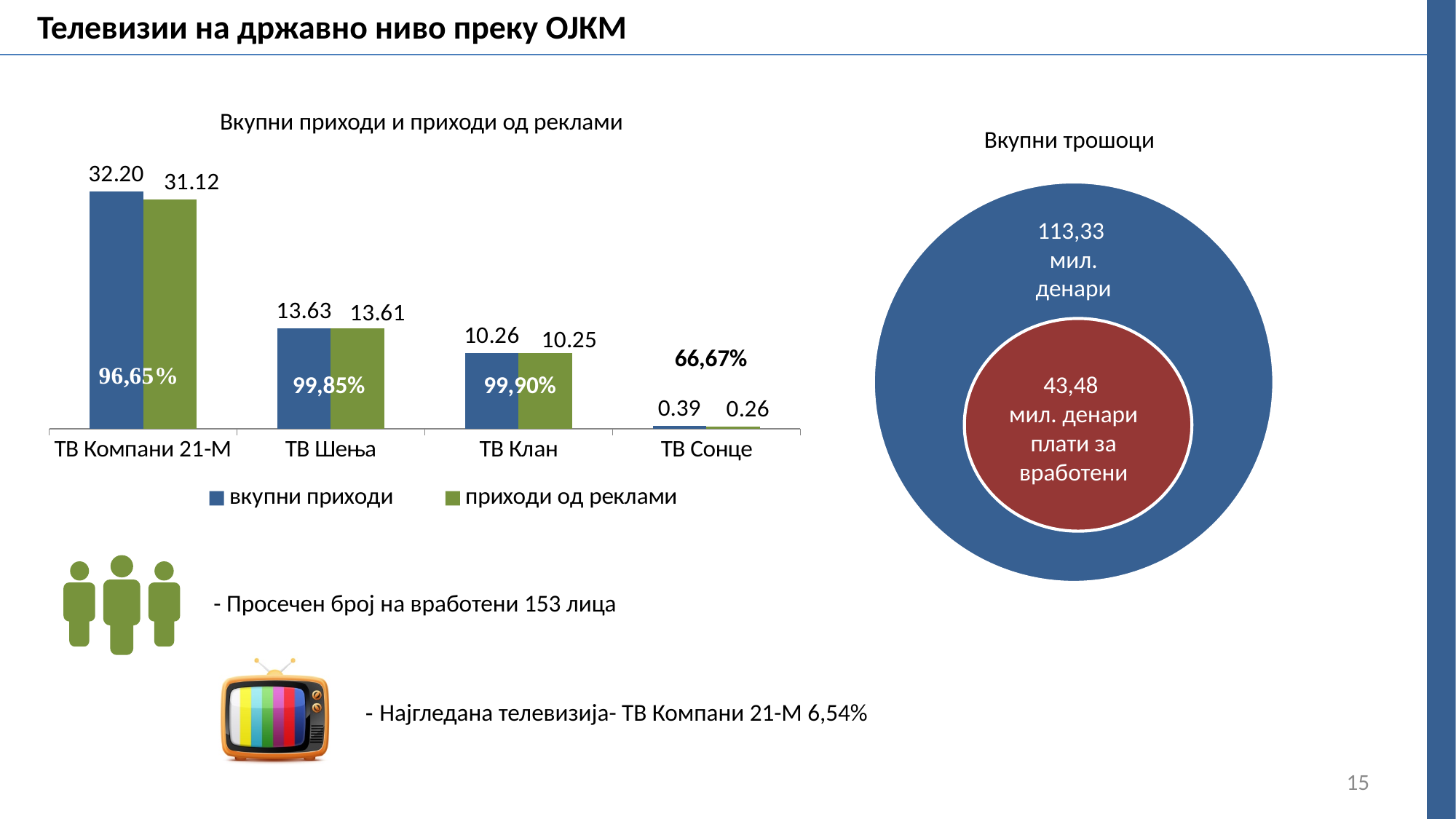
In the chart 'Вкупни приходи и приходи од реклами', which category has the lowest 'приходи од реклами'? ТВ Сонце In the chart 'Вкупни приходи и приходи од реклами', which is larger: 'вкупни приходи' for ТВ Шења or 'вкупни приходи' for ТВ Клан? ТВ Шења In the chart 'Вкупни приходи и приходи од реклами', what is the difference between 'вкупни приходи' and 'приходи од реклами' for ТВ Компани 21-М? 1.08 In the chart 'Вкупни приходи и приходи од реклами', what is the value of 'приходи од реклами' for ТВ Шења? 13.61 In the chart 'Вкупни приходи и приходи од реклами', what is the value of 'вкупни приходи' for ТВ Компани 21-М? 32.20 In the chart 'Вкупни приходи и приходи од реклами', what is the value of 'вкупни приходи' for ТВ Клан? 10.26 In the chart 'Вкупни приходи и приходи од реклами', which category has the highest 'вкупни приходи'? ТВ Компани 21-М How many categories are shown in the chart 'Вкупни приходи и приходи од реклами'? 4 In the chart 'Вкупни приходи и приходи од реклами', what is the value of 'приходи од реклами' for ТВ Сонце? 0.26 What kind of chart is 'Вкупни приходи и приходи од реклами'? bar chart In the chart 'Вкупни приходи и приходи од реклами', do the 'вкупни приходи' values rise or fall from left to right along the x axis? fall How many series does the legend of the chart 'Вкупни приходи и приходи од реклами' list? 2